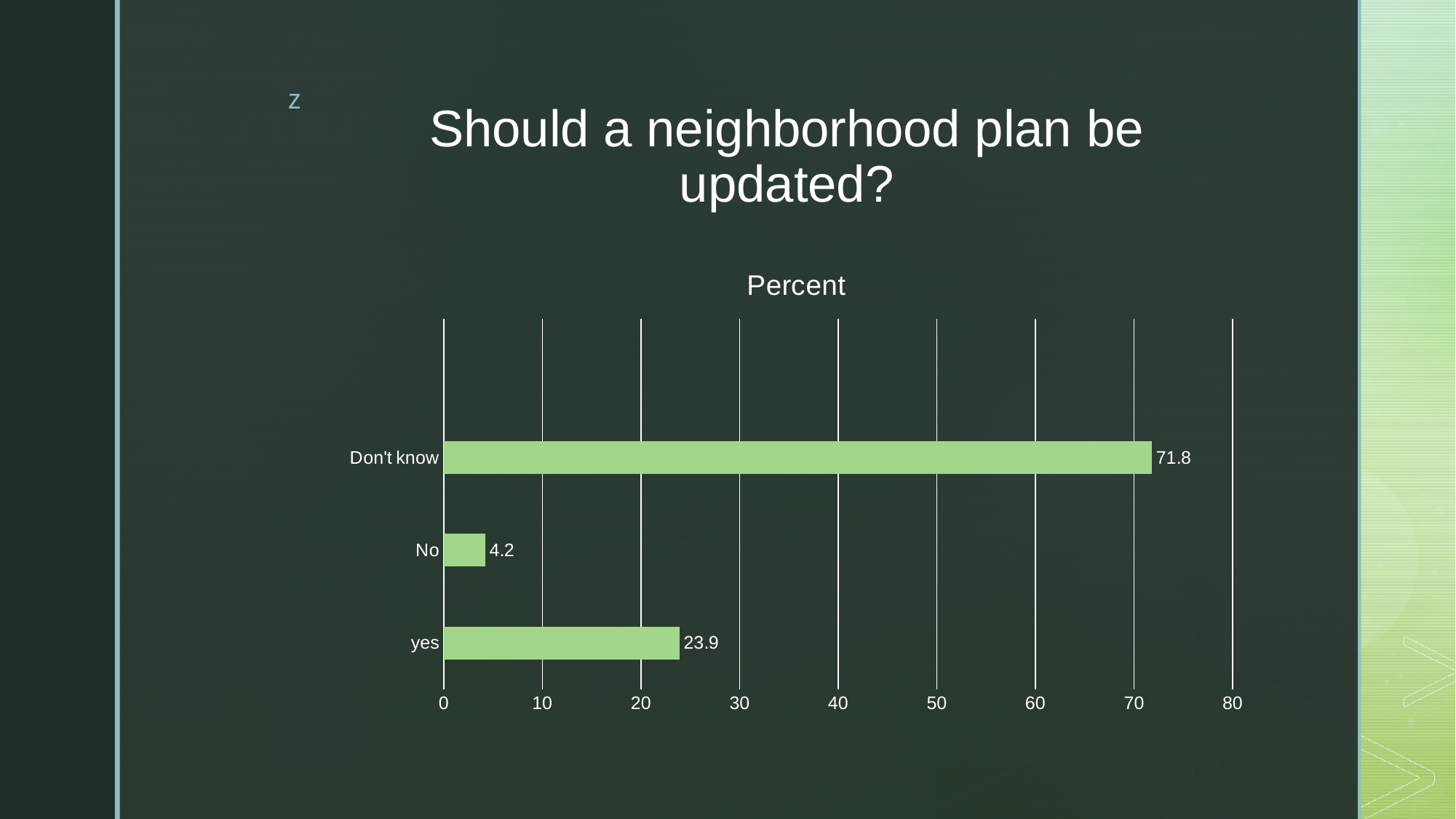
What is the title of the chart? Percent What is the difference between the values for "Don't know" and "yes"? 47.9 What is the value for "Don't know"? 71.8 Which category has the highest value? Don't know What is the value for "yes"? 23.9 How many categories are shown in the chart? 3 What is the value for "No"? 4.2 Which is larger, the value for "yes" or the value for "No"? yes What kind of chart is shown on the slide? bar chart Is the value for "Don't know" greater or less than 70? greater What is the difference between the values for "yes" and "No"? 19.7 Which category has the lowest value? No